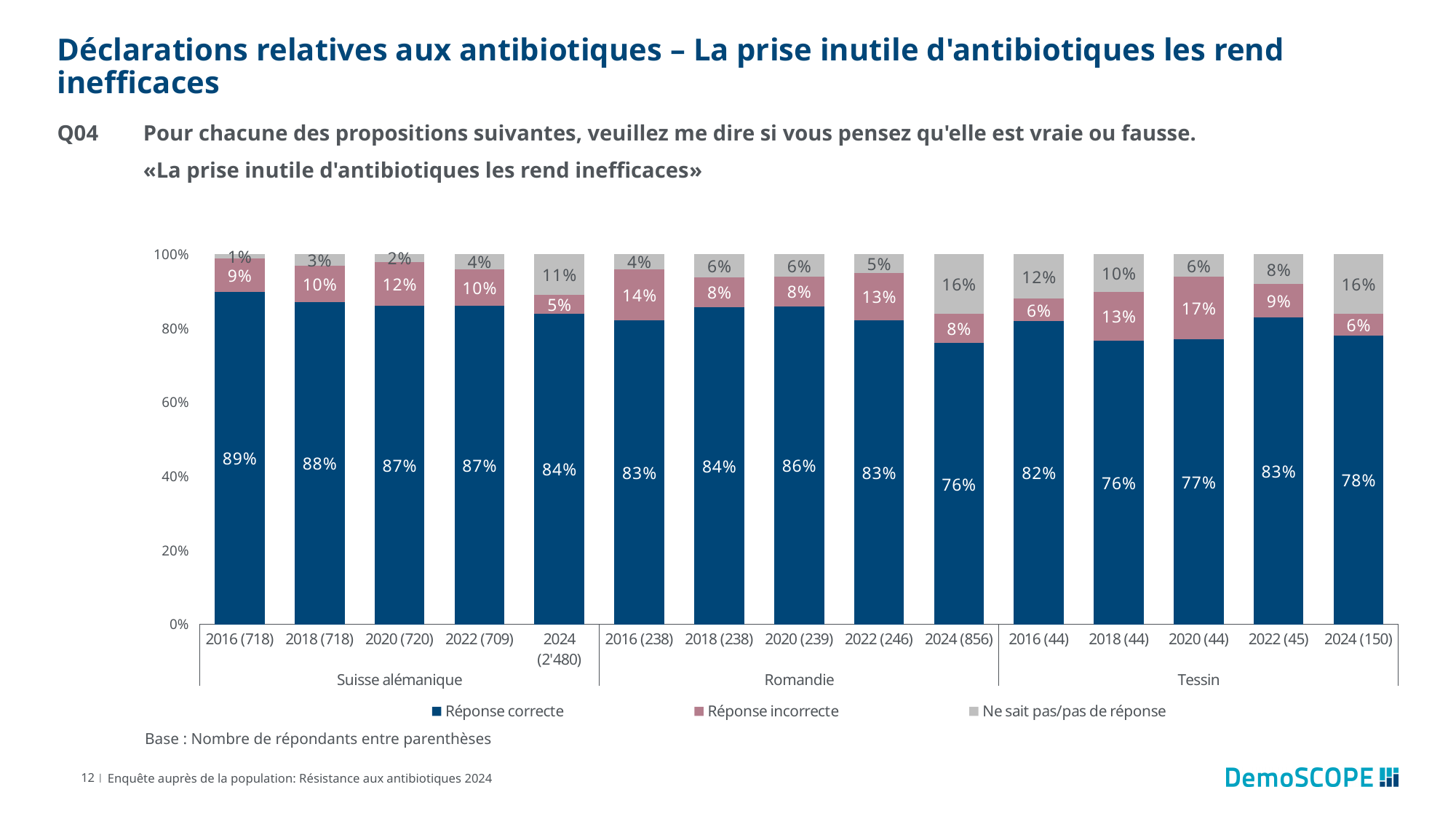
How many bars are plotted in the chart? 15 What percentage of respondents in Romandie gave an incorrect answer (Réponse incorrecte) in 2016 (238)? 14% How does the share of 'Réponse correcte' in Suisse alémanique change from 2016 to 2024? It falls How many series does the legend list? 3 Across all bars, which category has the highest share of 'Réponse correcte'? Suisse alémanique 2016 (718) Which legend entry is shown in dark blue? Réponse correcte Within Tessin, which year has the lowest share of 'Réponse correcte'? 2018 (44) Which has a larger share of 'Réponse incorrecte': Tessin 2020 (44) or Suisse alémanique 2020 (720)? Tessin 2020 (44) What is the difference in 'Réponse correcte' between Romandie 2020 (239) and Romandie 2024 (856)? 10 percentage points What percentage of respondents in Suisse alémanique gave the correct answer (Réponse correcte) in 2024? 84% What is the share of 'Ne sait pas/pas de réponse' for Tessin in 2024 (150)? 16% What kind of chart is shown on the slide? Stacked bar chart